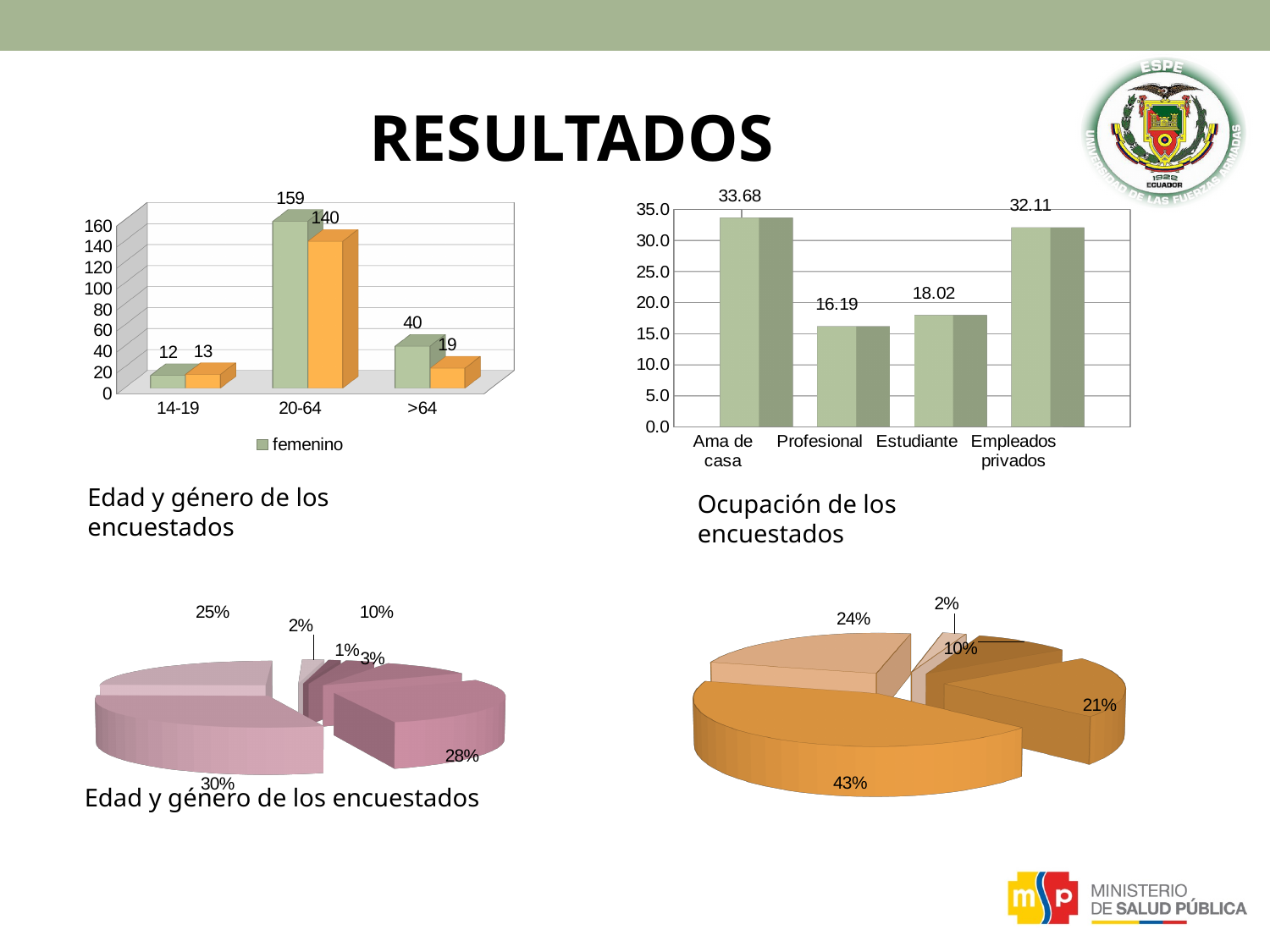
In the 'Ocupación de los encuestados' chart, what is the value for Estudiante? 18.02 In the top-left 'Edad y género de los encuestados' bar chart, how many series does the legend list? 1 In the 'Ocupación de los encuestados' chart, which occupation has the lowest value? Profesional In the top-left 'Edad y género de los encuestados' bar chart, what is the femenino value for the 20-64 age group? 159 What kind of chart is the 'Ocupación de los encuestados' chart? bar chart In the 'Ocupación de los encuestados' chart, what is the difference between the values for Ama de casa and Empleados privados? 1.57 In the 'Ocupación de los encuestados' chart, how many occupation categories are shown? 4 In the top-left 'Edad y género de los encuestados' bar chart, which age group has the highest femenino value? 20-64 In the bottom-right pie chart, what is the share of the largest slice? 43% In the 'Ocupación de los encuestados' chart, which occupation has the highest value? Ama de casa In the top-left 'Edad y género de los encuestados' bar chart, what is the difference between the femenino values for 20-64 and >64? 119 In the 'Ocupación de los encuestados' chart, what is the value for Ama de casa? 33.68